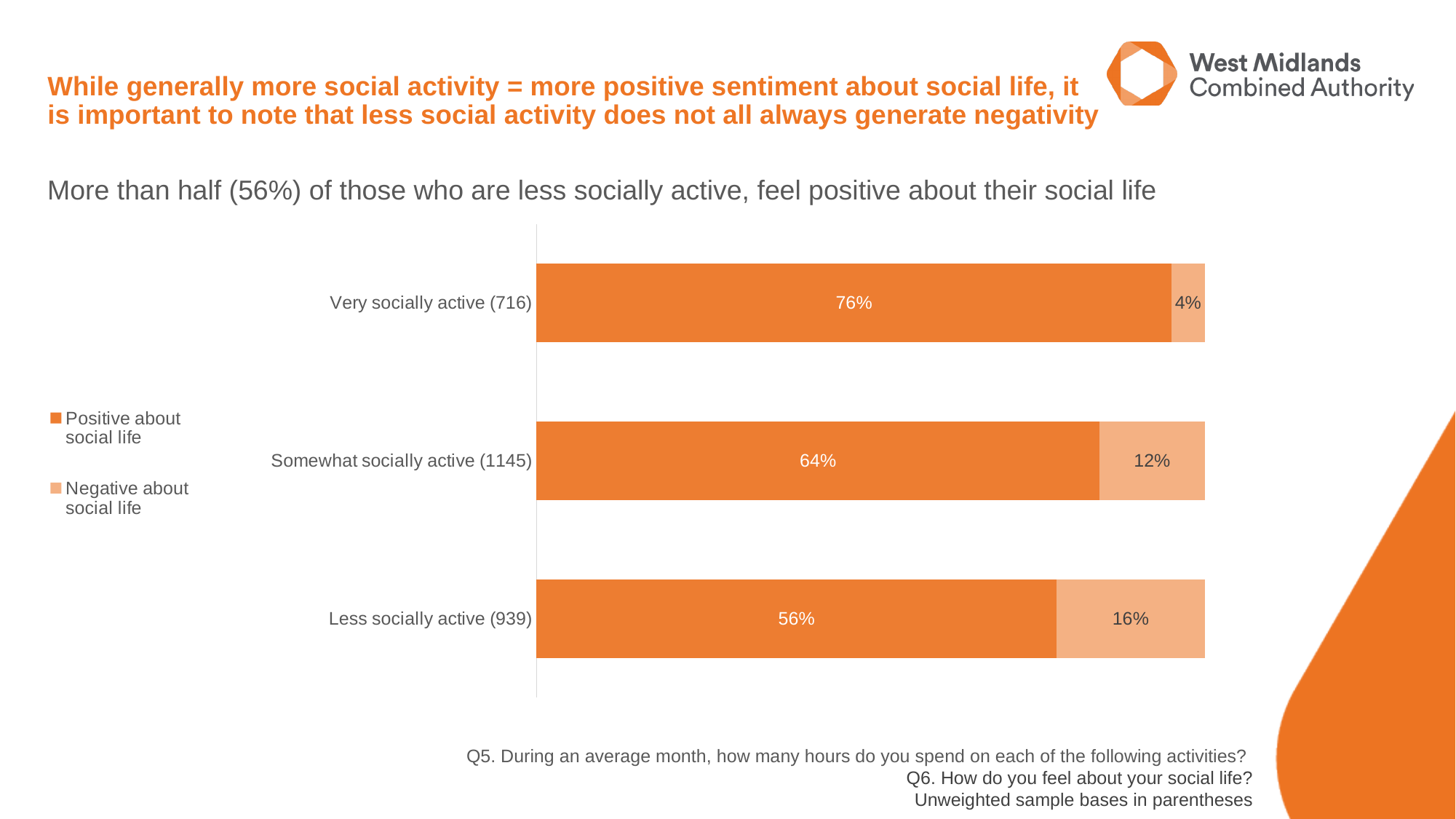
What are the two legend entries in the chart? Positive about social life; Negative about social life How many series does the legend list? 2 What percentage of the 'Very socially active (716)' group is positive about social life? 76% What percentage of the 'Less socially active (939)' group is negative about social life? 16% What is the difference between the positive shares of the 'Very socially active (716)' and 'Less socially active (939)' groups? 20 percentage points How many groups (categories) are shown in the chart? 3 What percentage of the 'Somewhat socially active (1145)' group is positive about social life? 64% Which group has the highest share positive about social life? Very socially active (716) Which group has the lowest share negative about social life? Very socially active (716) What kind of chart is shown on the slide? Stacked bar chart Which is larger: the negative share for 'Somewhat socially active (1145)' or for 'Less socially active (939)'? Less socially active (939) What is the combined total of positive and negative shares for the 'Somewhat socially active (1145)' bar? 76%